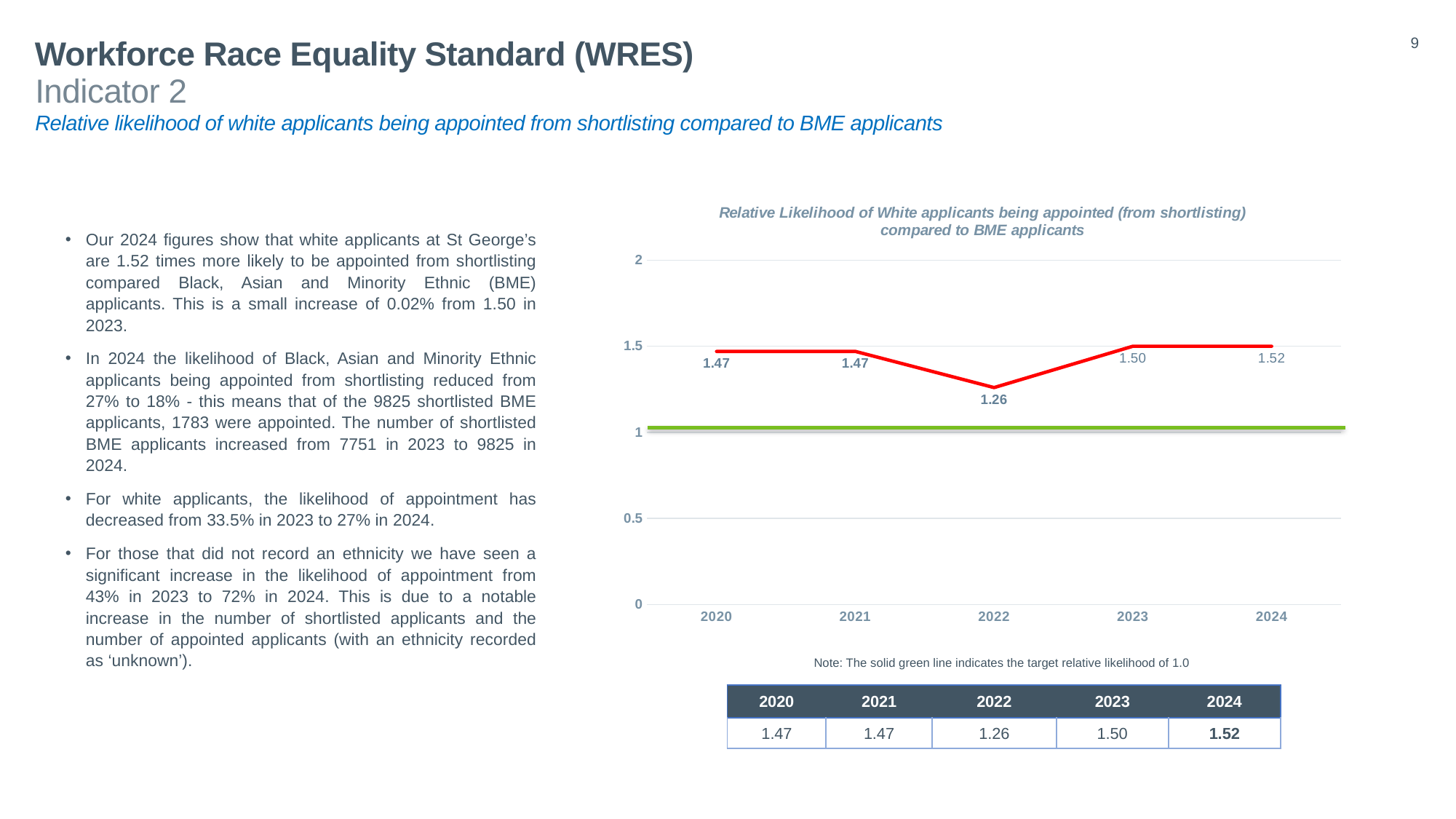
What is the relative likelihood value for 2020? 1.47 How many years are plotted on the x axis? 5 What is the difference between the 2023 and 2022 values? 0.24 Is the value for 2022 greater or less than 1? greater Which is larger, the value for 2021 or the value for 2022? 2021 What does the solid green line on the chart indicate? the target relative likelihood of 1.0 Which year has the lowest relative likelihood value? 2022 Which year has the highest relative likelihood value? 2024 What kind of chart is shown? line chart Does the red line rise or fall from 2022 to 2024? rise What is the relative likelihood value for 2024? 1.52 What is the relative likelihood value for 2022? 1.26